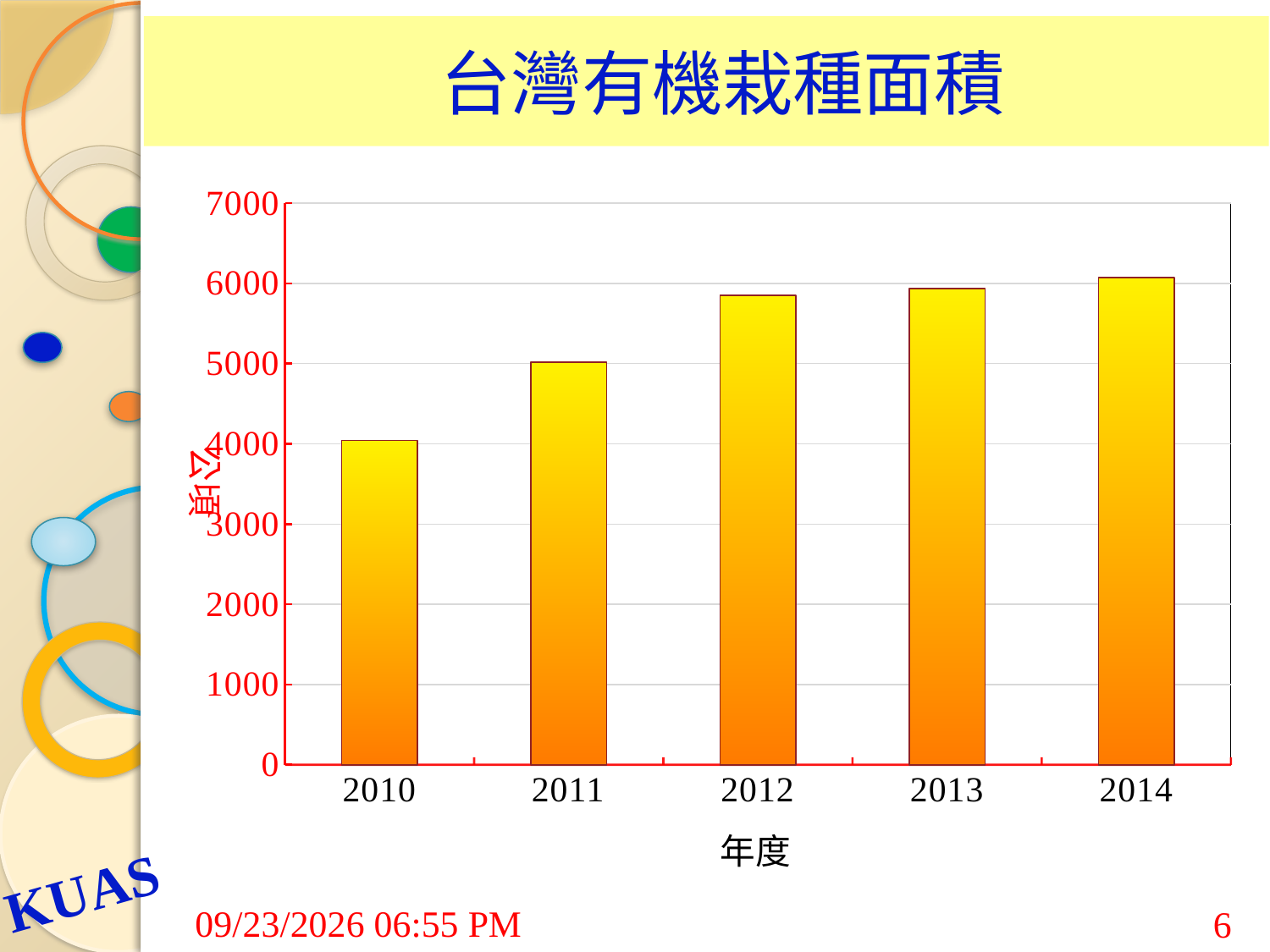
Which year has the lowest value in the chart? 2010 How many years are shown on the x axis of the chart? 5 What is the label of the x axis of the chart? 年度 Which is larger, the value for 2011 or the value for 2012? 2012 Is the value for 2014 greater or less than 6000? greater Do the values rise or fall from 2010 to 2014? rise What is the title of the chart on the slide? 台灣有機栽種面積 Is the value for 2011 greater or less than 4000? greater Which is larger, the value for 2010 or the value for 2011? 2011 Is the value for 2010 greater or less than 5000? less What kind of chart is shown on the slide? bar chart